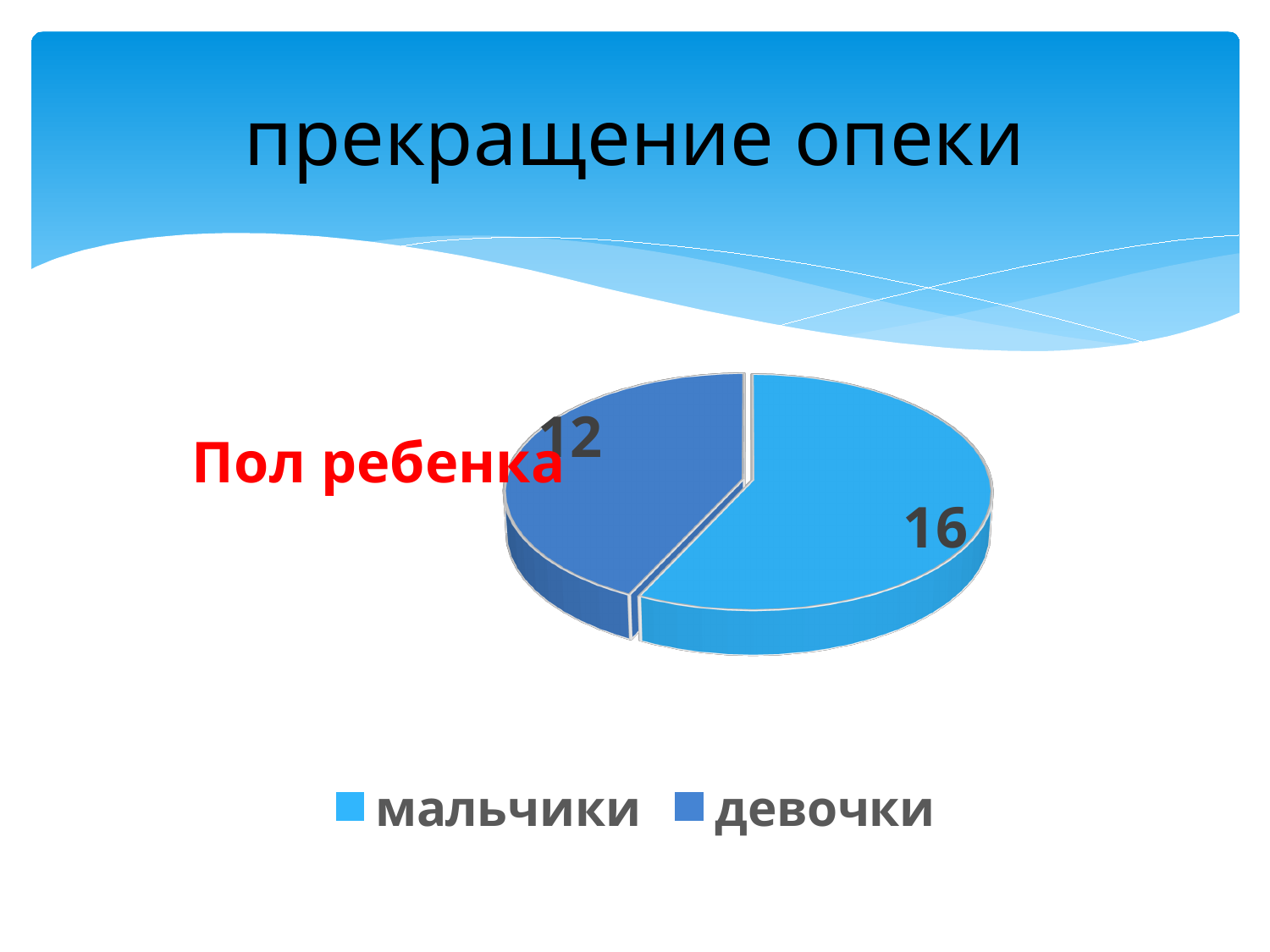
Which legend entry is shown in the lighter blue colour? мальчики What is the total of all slices in the pie chart? 28 What is the value for мальчики? 16 What is the value for девочки? 12 What is the difference between the values for мальчики and девочки? 4 How many slices does the pie chart have? 2 What type of chart is shown on the slide? pie chart What is the title of the chart? Пол ребенка Which category has the largest slice of the pie? мальчики How many entries does the legend list? 2 Which category has the smallest slice of the pie? девочки Which is larger, the value for мальчики or the value for девочки? мальчики